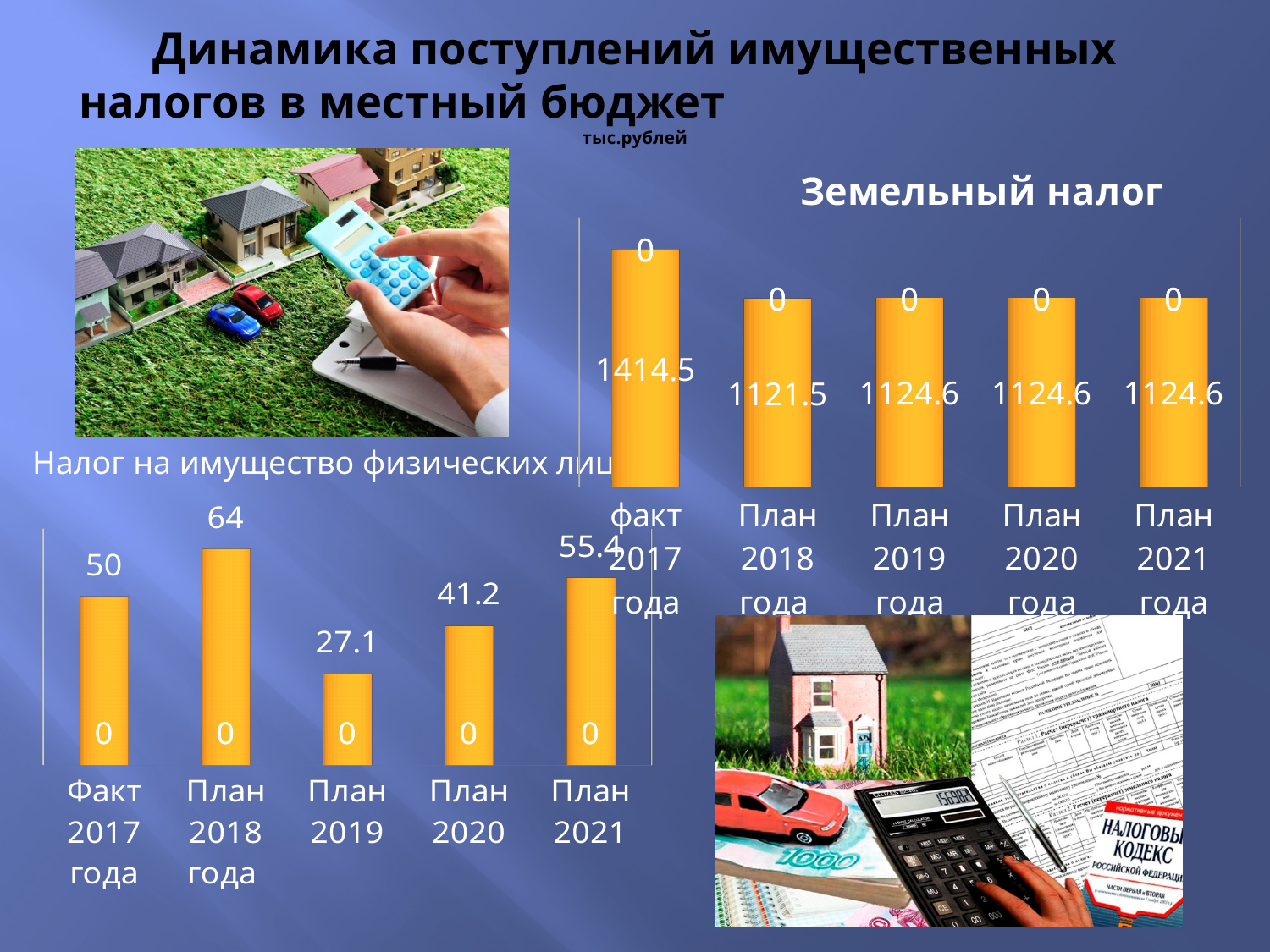
On the 'Налог на имущество физических лиц' chart, what is the value for План 2021? 55.4 On the 'Налог на имущество физических лиц' chart, which category has the lowest value? План 2019 On the 'Налог на имущество физических лиц' chart, which is larger: Факт 2017 года or План 2020? Факт 2017 года On the 'Земельный налог' chart, what is the difference between факт 2017 года and План 2018 года? 293 On the 'Земельный налог' chart, which category has the highest value? факт 2017 года On the 'Земельный налог' chart, what is the value for План 2018 года? 1121.5 On the 'Налог на имущество физических лиц' chart, what is the difference between План 2018 года and План 2019? 36.9 On the 'Налог на имущество физических лиц' chart, what is the value for План 2019? 27.1 On the 'Земельный налог' chart, what is the value for факт 2017 года? 1414.5 What type of chart is the 'Земельный налог' chart? Bar chart On the 'Земельный налог' chart, how many categories are shown? 5 On the 'Налог на имущество физических лиц' chart, which category has the highest value? План 2018 года